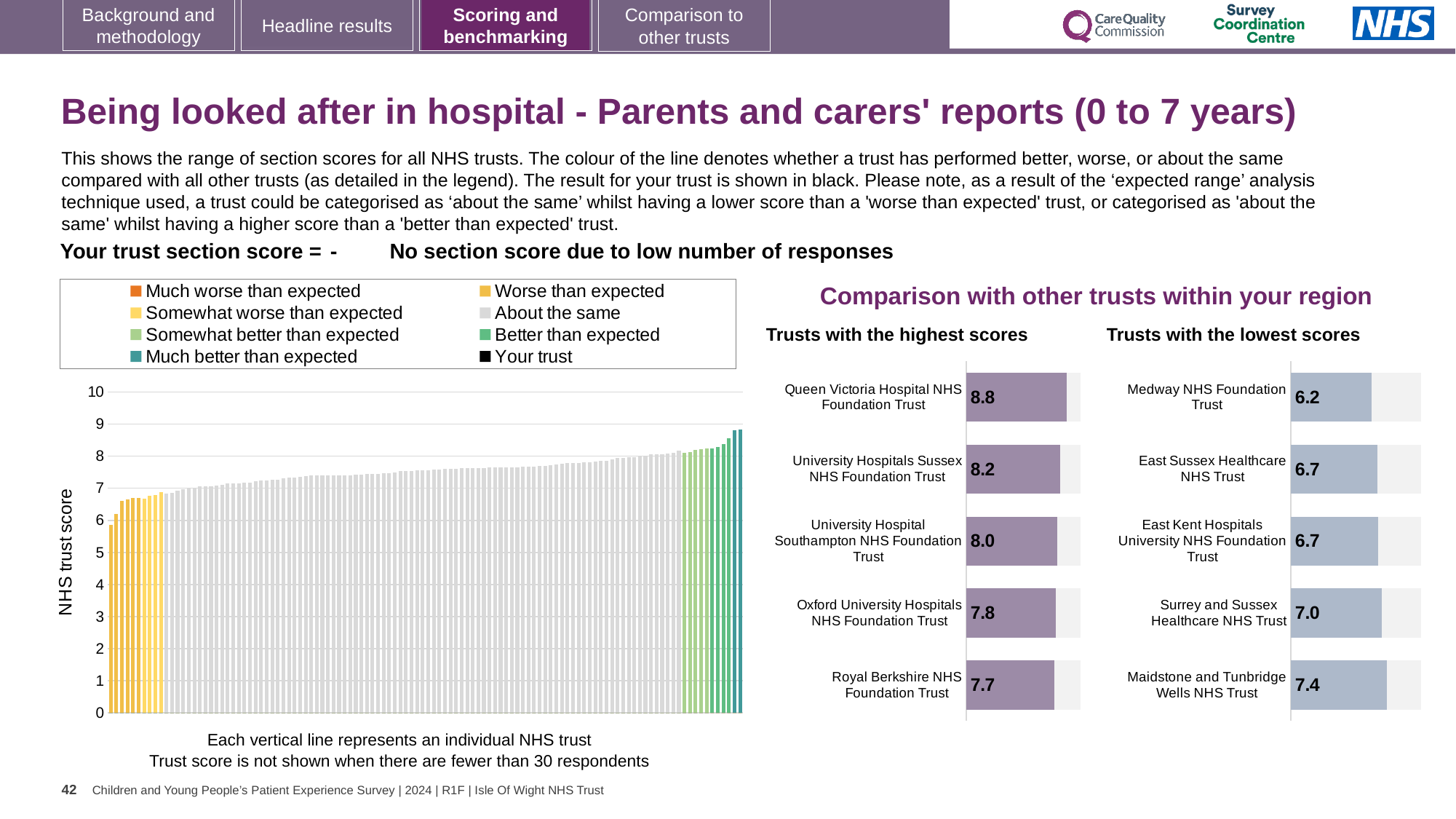
In the 'Trusts with the lowest scores' chart, what is the score for Medway NHS Foundation Trust? 6.2 How many entries does the legend of the main chart on the left list? 8 In the 'Trusts with the highest scores' chart, which has the higher score: University Hospitals Sussex NHS Foundation Trust or Oxford University Hospitals NHS Foundation Trust? University Hospitals Sussex NHS Foundation Trust In the 'Trusts with the lowest scores' chart, which trust has the lowest score? Medway NHS Foundation Trust In the 'Trusts with the lowest scores' chart, what is the difference between the scores of Maidstone and Tunbridge Wells NHS Trust and Medway NHS Foundation Trust? 1.2 What kind of chart is the main chart on the left showing the range of section scores for all NHS trusts? Bar chart In the 'Trusts with the highest scores' chart, which trust has the highest score? Queen Victoria Hospital NHS Foundation Trust In the 'Trusts with the lowest scores' chart, what is the score for East Kent Hospitals University NHS Foundation Trust? 6.7 In the main chart on the left, do the trust scores rise or fall from left to right? Rise In the 'Trusts with the highest scores' chart, what is the score for Queen Victoria Hospital NHS Foundation Trust? 8.8 How many trusts are listed in the 'Trusts with the highest scores' chart? 5 In the 'Trusts with the highest scores' chart, what is the difference between the scores of Queen Victoria Hospital NHS Foundation Trust and Royal Berkshire NHS Foundation Trust? 1.1